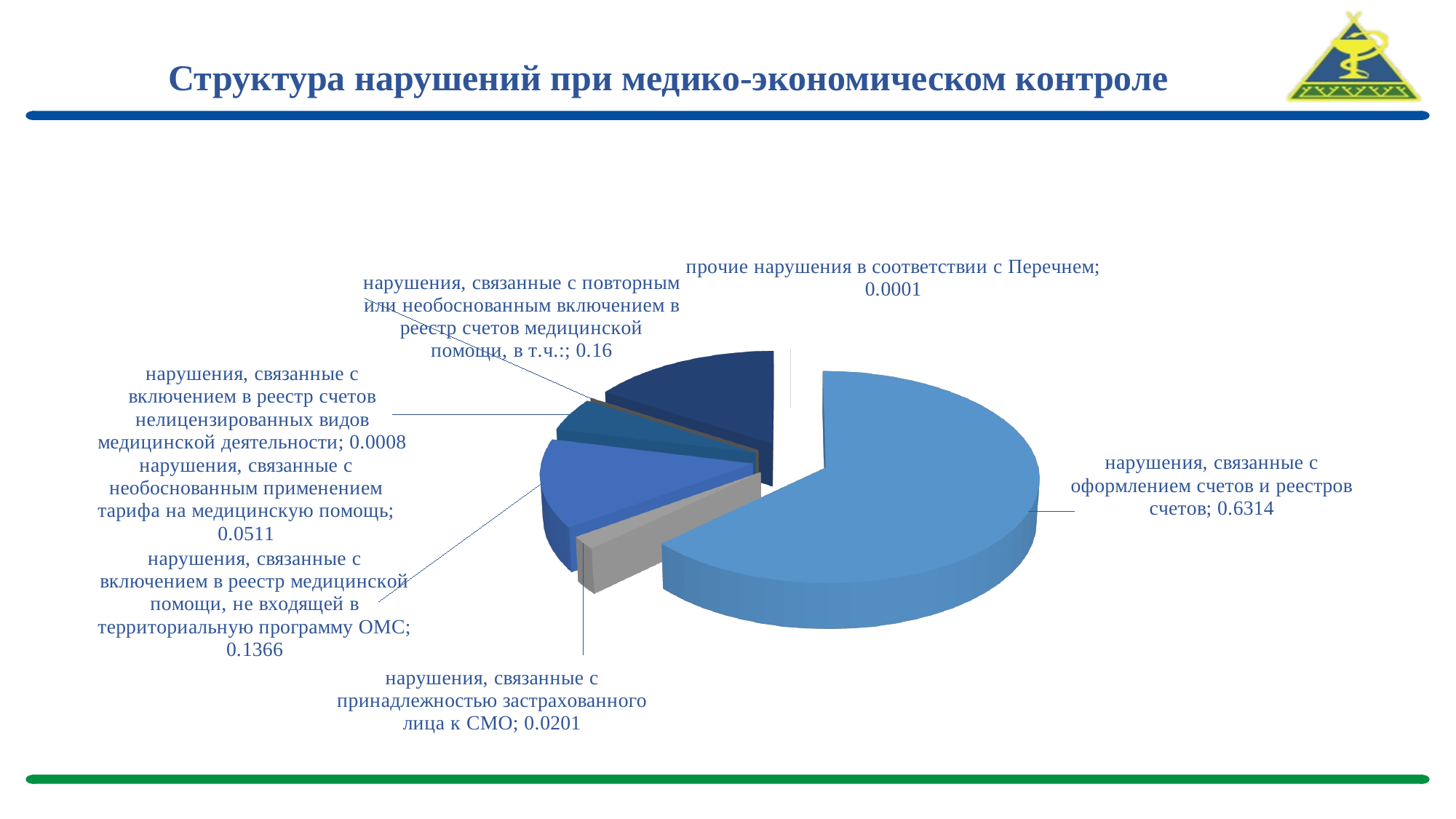
What is the difference between the value for «нарушения, связанные с оформлением счетов и реестров счетов» and the value for «нарушения, связанные с включением в реестр медицинской помощи, не входящей в территориальную программу ОМС»? 0.4948 What kind of chart is shown on the slide? Pie chart Which category has the largest slice of the pie? нарушения, связанные с оформлением счетов и реестров счетов What is the value for «нарушения, связанные с принадлежностью застрахованного лица к СМО»? 0.0201 What is the title of the chart on the slide? Структура нарушений при медико-экономическом контроле What is the value for «нарушения, связанные с включением в реестр медицинской помощи, не входящей в территориальную программу ОМС»? 0.1366 What is the value for «прочие нарушения в соответствии с Перечнем»? 0.0001 What is the value for «нарушения, связанные с повторным или необоснованным включением в реестр счетов медицинской помощи, в т.ч.:»? 0.16 How many categories (slices) does the pie chart have? 7 Which is larger: the value for «нарушения, связанные с необоснованным применением тарифа на медицинскую помощь» or the value for «нарушения, связанные с принадлежностью застрахованного лица к СМО»? нарушения, связанные с необоснованным применением тарифа на медицинскую помощь Which category has the smallest value in the pie chart? прочие нарушения в соответствии с Перечнем What is the value for «нарушения, связанные с оформлением счетов и реестров счетов»? 0.6314